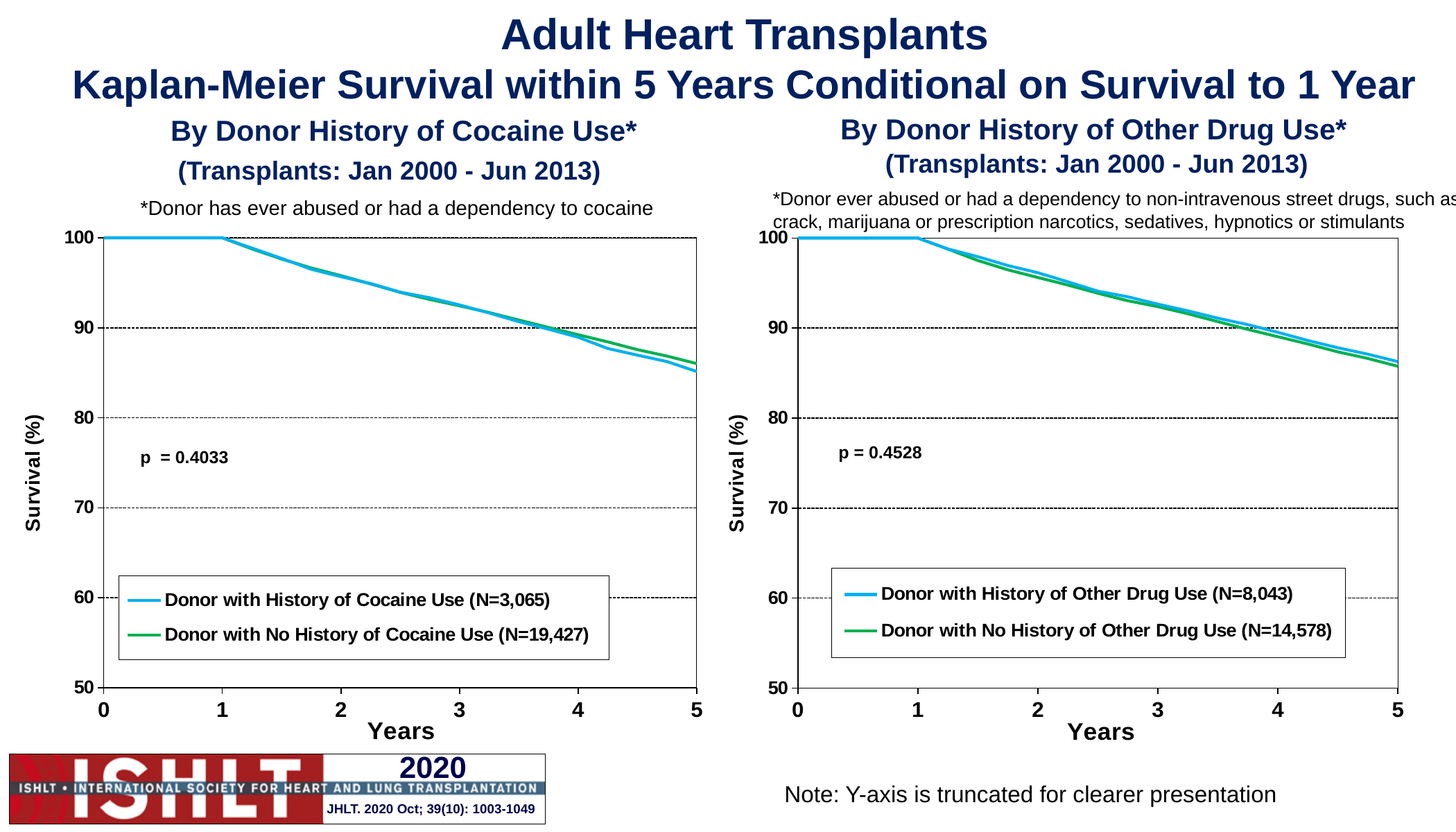
In the right chart, 'By Donor History of Other Drug Use', is the survival for donors with a history of other drug use at year 3 greater or less than 90? greater In the right chart, 'By Donor History of Other Drug Use', do the survival curves rise or fall as years increase? fall How many series does the legend of the left chart, 'By Donor History of Cocaine Use', list? 2 In the left chart, 'By Donor History of Cocaine Use', is the survival for donors with no history of cocaine use at year 5 greater or less than 80? greater How many series does the legend of the right chart, 'By Donor History of Other Drug Use', list? 2 In the left chart, 'By Donor History of Cocaine Use', do the survival curves rise or fall as years increase? fall In the left chart, 'By Donor History of Cocaine Use', what is the survival value for both series at year 1? 100 In the right chart, 'By Donor History of Other Drug Use', what is the N for donors with no history of other drug use? 14,578 In the left chart, 'By Donor History of Cocaine Use', is the survival for donors with a history of cocaine use at year 5 greater or less than 90? less In the left chart, 'By Donor History of Cocaine Use', what is the N for donors with a history of cocaine use? 3,065 What kind of chart is the left chart, 'By Donor History of Cocaine Use'? line chart